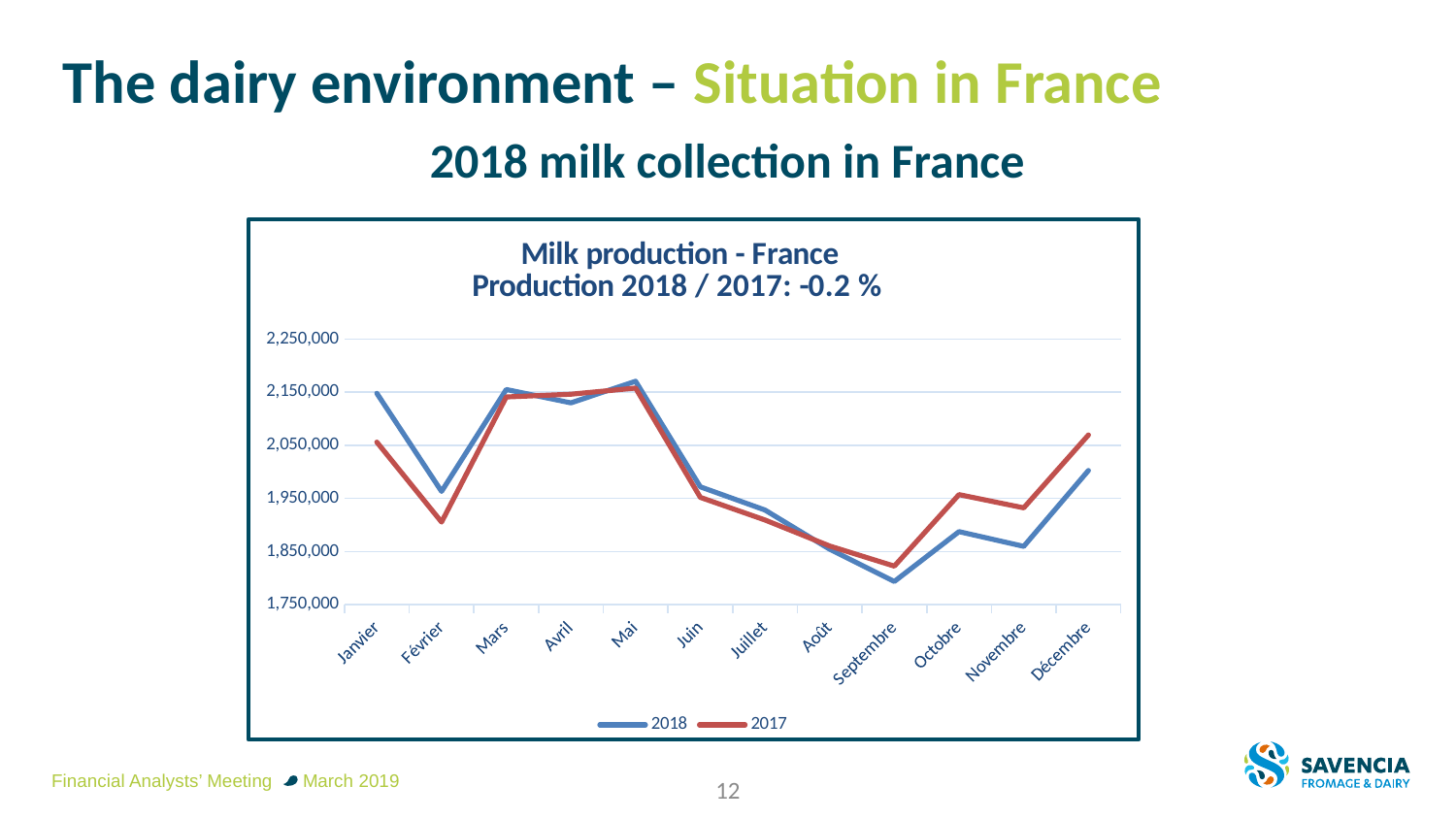
What kind of chart is shown on the slide? line chart How many series does the chart legend list? 2 How many months are plotted along the x axis of the chart? 12 In which month is the 2017 milk production at its lowest? Septembre Is the 2018 value for Septembre greater or less than 1,850,000? less What percentage change in production from 2017 to 2018 is stated in the chart title? -0.2 % In Janvier, which series has the higher value, 2018 or 2017? 2018 In which month is the 2018 milk production at its lowest? Septembre Is the 2018 value for Décembre greater or less than 1,950,000? greater Does the 2018 line rise or fall between Mai and Septembre? fall In Décembre, which series has the higher value, 2018 or 2017? 2017 Is the 2017 value for Février greater or less than 1,950,000? less